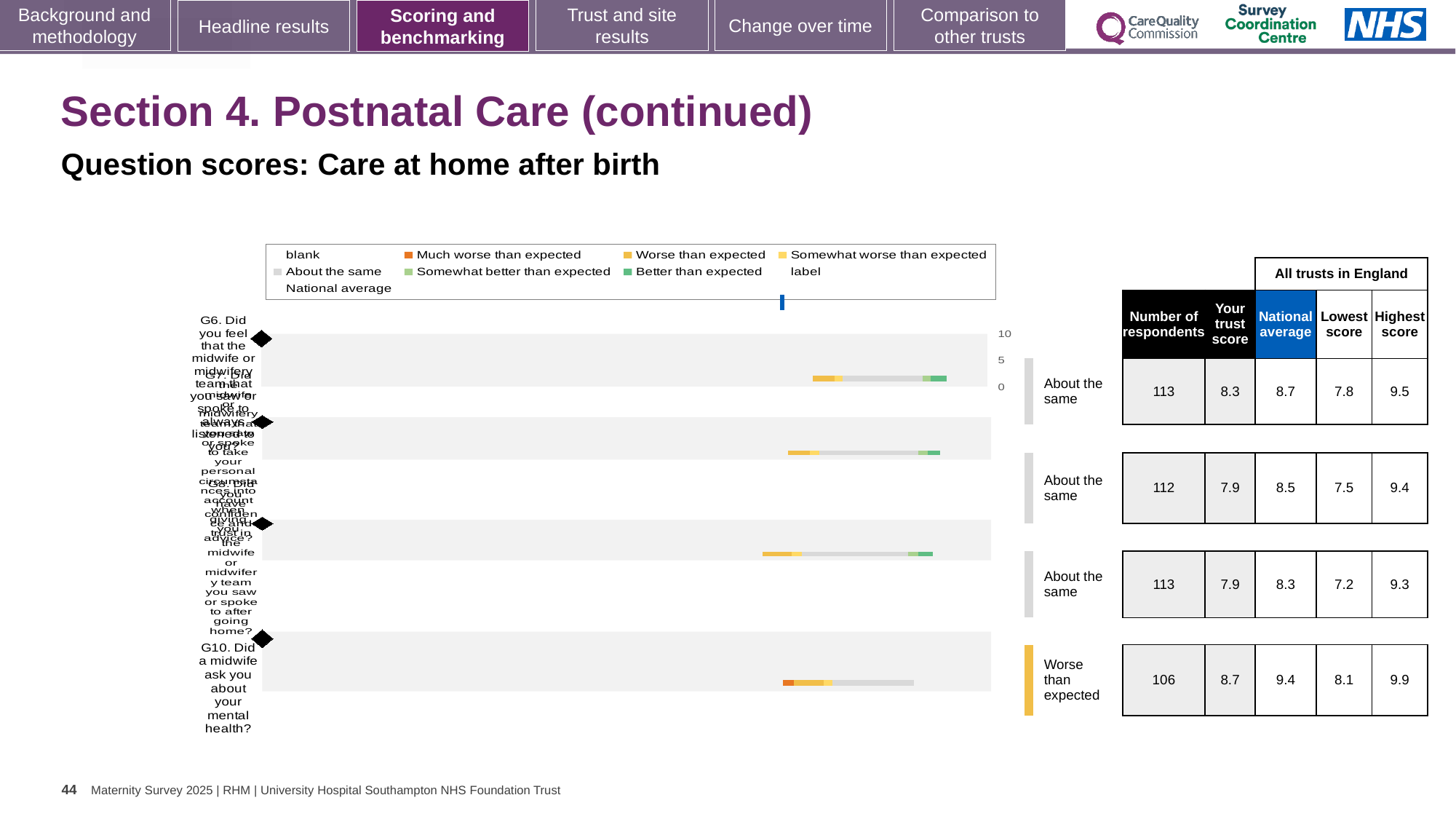
What is the difference between the national average and the trust score for question G10? 0.7 What colour is the legend marker for 'Much worse than expected'? Orange For question G10, which is larger: the trust score or the national average? National average What is the benchmark rating shown for question G10 (Did a midwife ask you about your mental health?)? Worse than expected How many question rows (bars) are plotted in the chart? 4 What kind of chart is shown on the slide? Bar chart How many respondents answered question G10 (Did a midwife ask you about your mental health?)? 106 Which question row has the lowest number of respondents? G10 How many of the question rows are rated 'About the same'? 3 What is the difference between the highest score and the lowest score for question G10? 1.8 What is the national average for question G10 (Did a midwife ask you about your mental health?)? 9.4 What is the trust score for question G10 (Did a midwife ask you about your mental health?)? 8.7